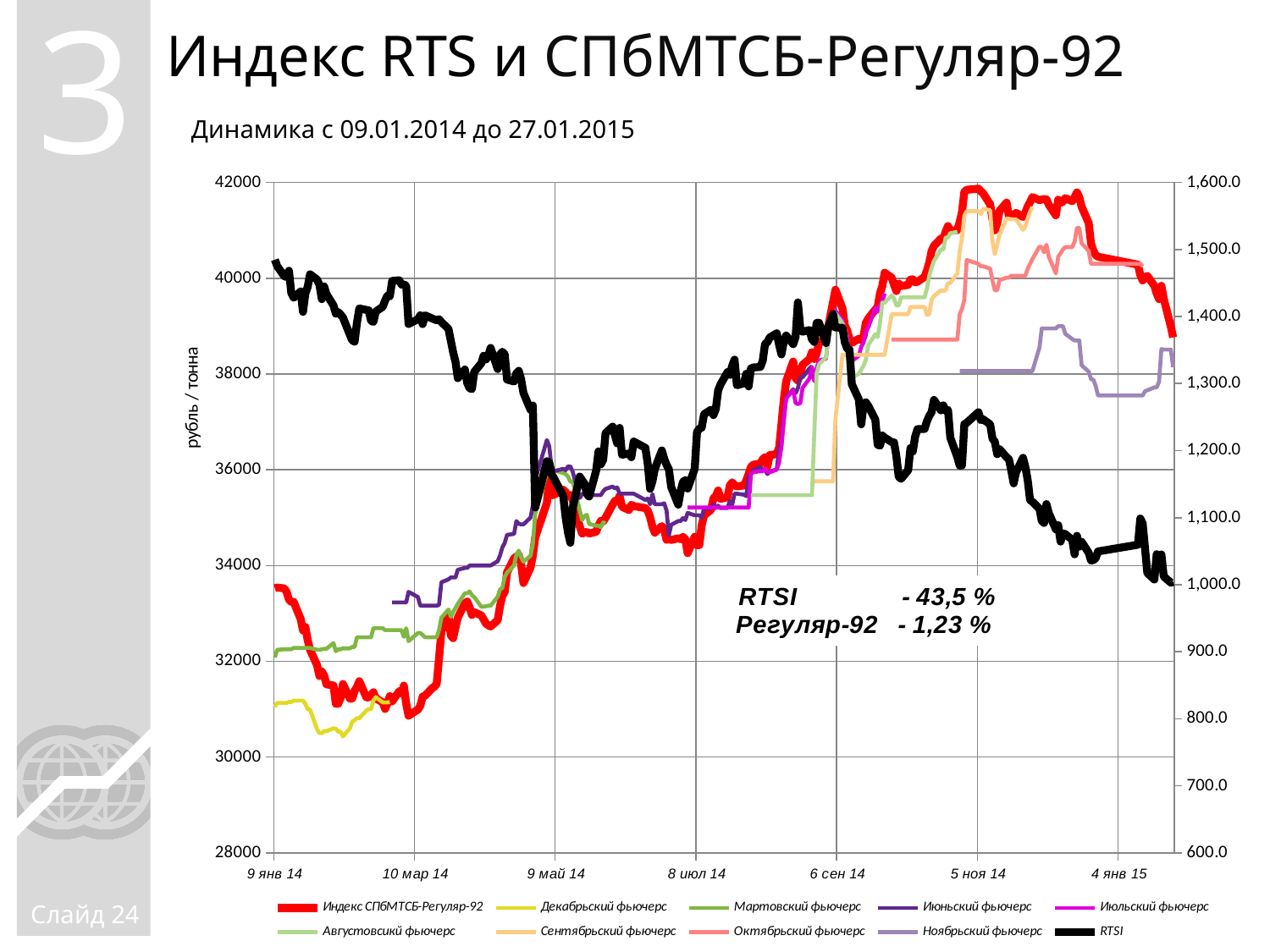
What kind of chart is shown on the slide? line chart Is the RTSI value at the start of the period (9 янв 14) greater or less than 1,400.0? greater What is the label of the left vertical axis? рубль / тонна What colour is the RTSI line in the chart? black Does the Индекс СПбМТСБ-Регуляр-92 line rise or fall overall from 9 янв 14 to the end of the period? rise Does the RTSI line rise or fall overall from 9 янв 14 to the end of the period? fall What percentage change is shown for Регуляр-92 in the annotation on the chart? - 1,23 % What percentage change is shown for RTSI in the annotation on the chart? - 43,5 % Is the Индекс СПбМТСБ-Регуляр-92 value at the start of the period (9 янв 14) greater or less than 34000? less Is the RTSI value at the end of the period greater or less than 1,100.0? less How many series does the legend list? 10